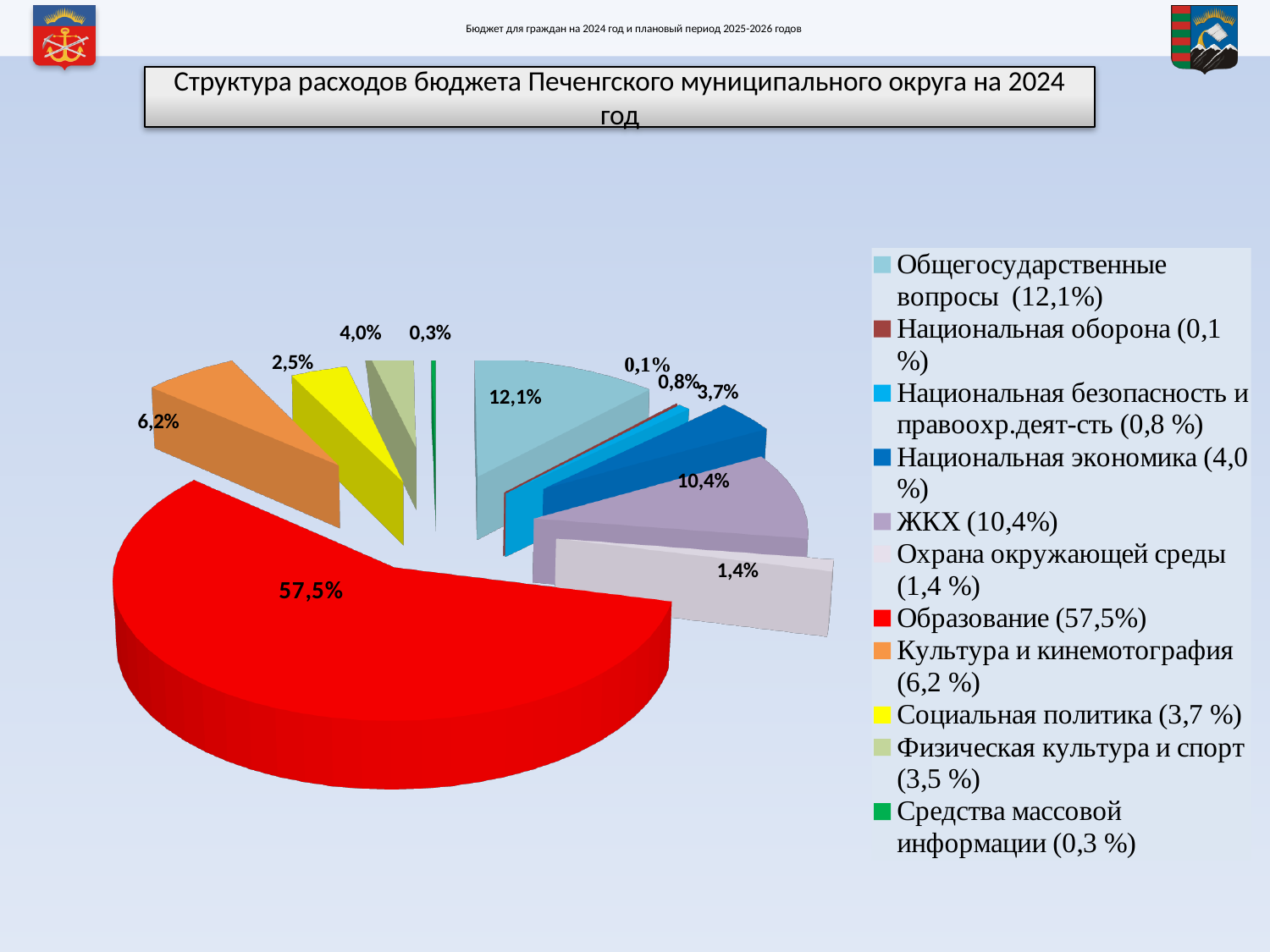
Which category has the largest share of the pie? Образование What share of the budget expenditure goes to Образование? 57,5% What is the value for ЖКХ? 10,4% What is the difference between the shares of Образование and ЖКХ? 47,1% What is the value for Охрана окружающей среды? 1,4 % Which category has the smallest share of the pie? Национальная оборона How many categories does the legend list? 11 What is the value for Общегосударственные вопросы? 12,1% Which is larger, the share of Общегосударственные вопросы or the share of ЖКХ? Общегосударственные вопросы What is the value for Культура и кинемотография? 6,2 % What is the title of the chart? Структура расходов бюджета Печенгского муниципального округа на 2024 год What kind of chart is shown on the slide? pie chart